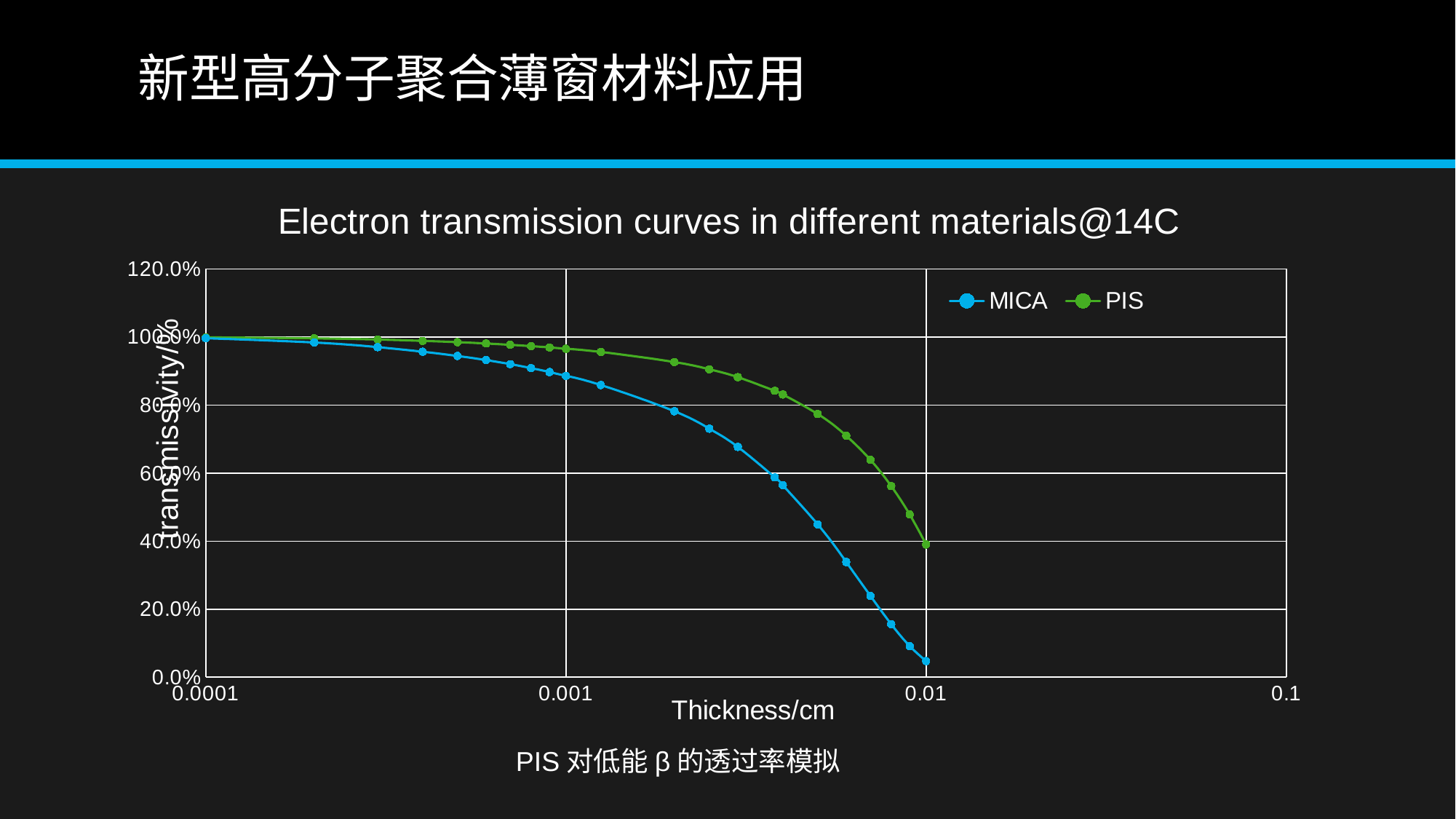
Is the transmissivity of PIS at a thickness of 0.001 cm greater or less than 80.0%? greater How many series does the legend list? 2 Do the transmissivity values for MICA rise or fall as thickness increases? fall What is the title of the chart? Electron transmission curves in different materials@14C At a thickness of 0.001 cm, which series has the lower transmissivity, MICA or PIS? MICA Is the transmissivity of PIS at a thickness of 0.01 cm greater or less than 20.0%? greater Which series is drawn in green? PIS Is the transmissivity of MICA at a thickness of 0.01 cm greater or less than 20.0%? less What kind of chart is shown on the slide? line chart At a thickness of 0.01 cm, which series has the higher transmissivity, MICA or PIS? PIS Do the transmissivity values for PIS rise or fall as thickness increases? fall